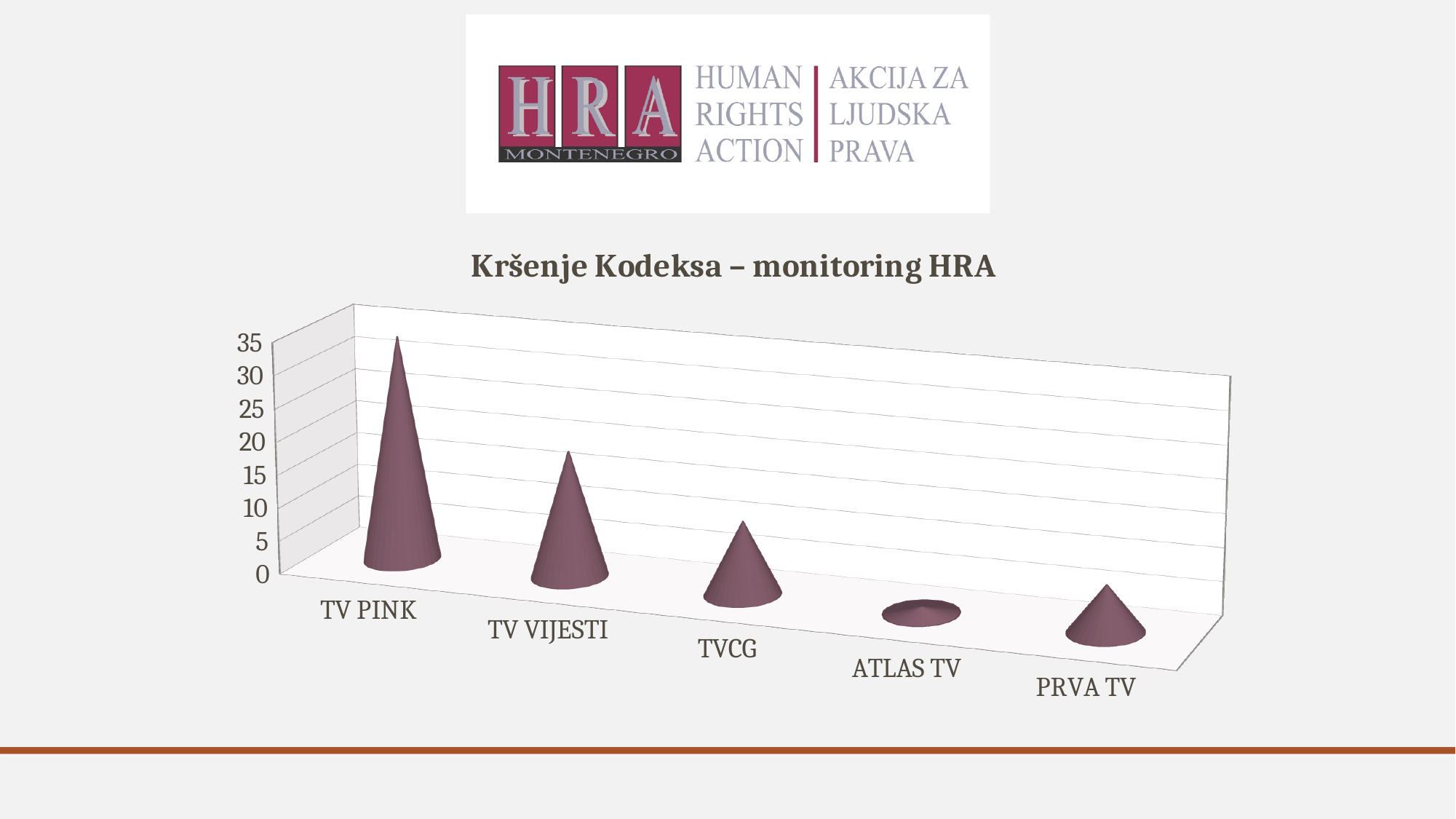
Which has a larger value, TV VIJESTI or TVCG? TV VIJESTI Which category has the highest value in the chart? TV PINK How many categories are shown on the x axis of the chart? 5 What kind of chart is shown on the slide? bar chart Is the value for TV VIJESTI greater or less than 10? greater Which has a larger value, TV PINK or TV VIJESTI? TV PINK Which has a larger value, PRVA TV or ATLAS TV? PRVA TV Which category has the lowest value in the chart? ATLAS TV Is the value for TVCG greater or less than 20? less Is the value for TV PINK greater or less than 25? greater What is the title of the chart? Kršenje Kodeksa – monitoring HRA